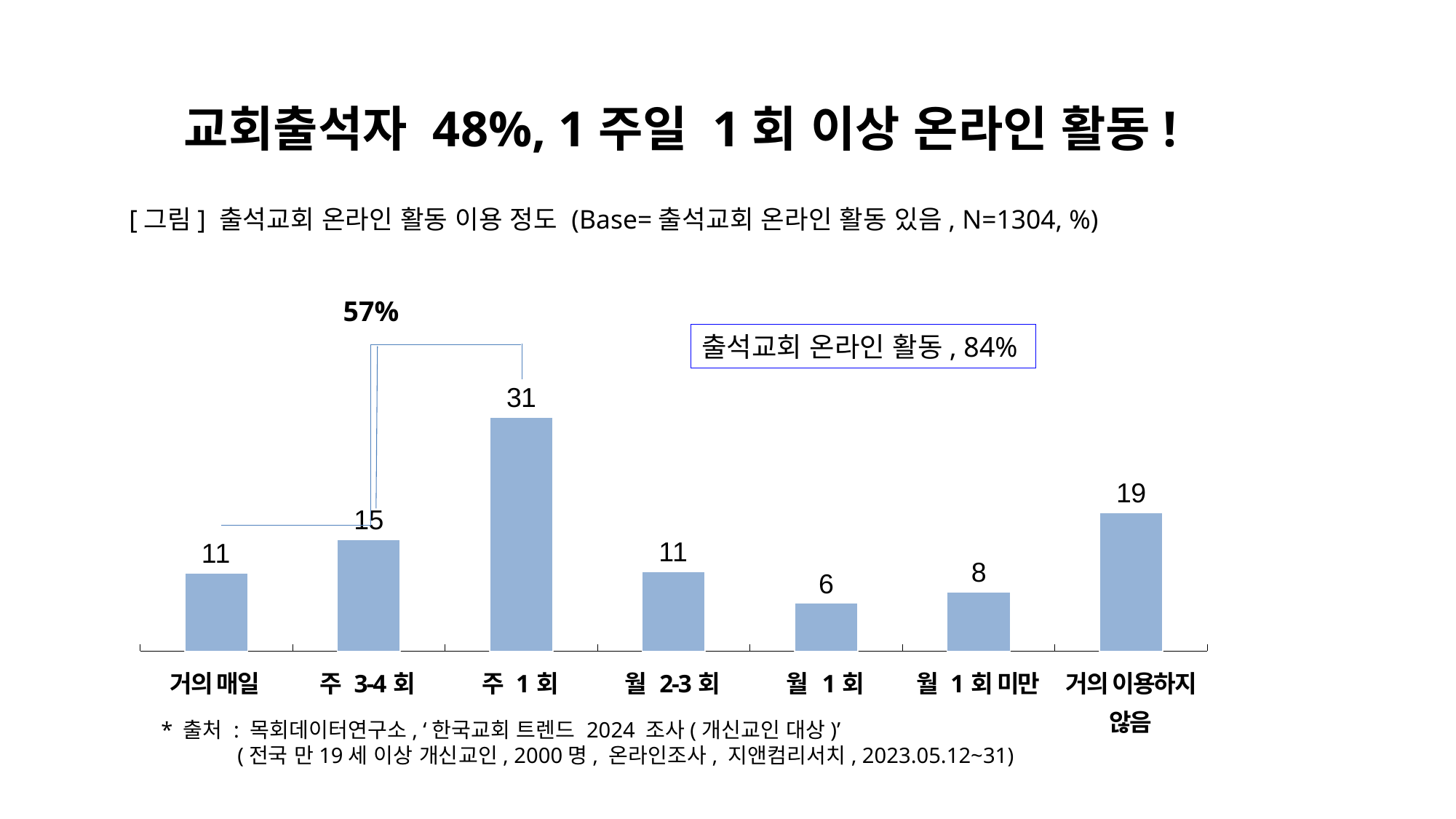
What is the value for 주 1회? 31 How many categories are shown on the x axis? 7 What percentage is shown above the bracket spanning the first three bars? 57% What is the value for 주 3-4회? 15 What is the difference between the values for 주 1회 and 거의 이용하지 않음? 12 Which category has the highest value? 주 1회 What percentage is shown in the box labelled 출석교회 온라인 활동? 84% Which is larger, the value for 거의 매일 or the value for 주 3-4회? 주 3-4회 Which category has the lowest value? 월 1회 What is the value for 거의 이용하지 않음? 19 What is the value for 월 1회? 6 What kind of chart is shown on the slide? Bar chart